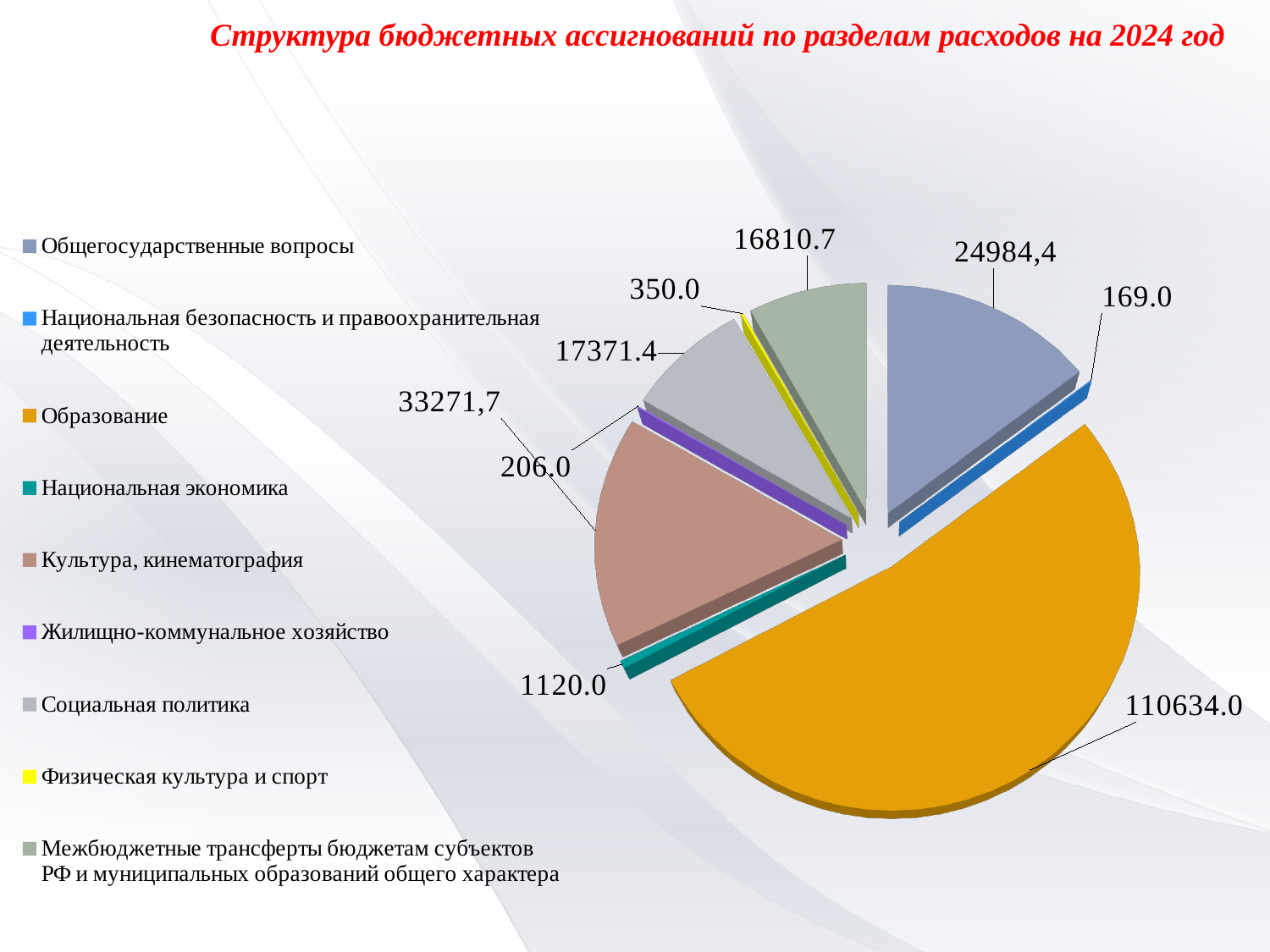
Which category has the smallest value? Национальная безопасность и правоохранительная деятельность What is the title of the chart? Структура бюджетных ассигнований по разделам расходов на 2024 год What is the value for Образование? 110634.0 Which category has the largest slice of the pie? Образование What type of chart is shown on the slide? Pie chart How many categories does the legend list? 9 What is the value for Национальная безопасность и правоохранительная деятельность? 169.0 What is the value for Культура, кинематография? 33271,7 What is the value for Общегосударственные вопросы? 24984,4 What is the difference between the values for Национальная экономика and Физическая культура и спорт? 770.0 Which is larger: Социальная политика or Межбюджетные трансферты бюджетам субъектов РФ и муниципальных образований общего характера? Социальная политика What is the value for Социальная политика? 17371.4